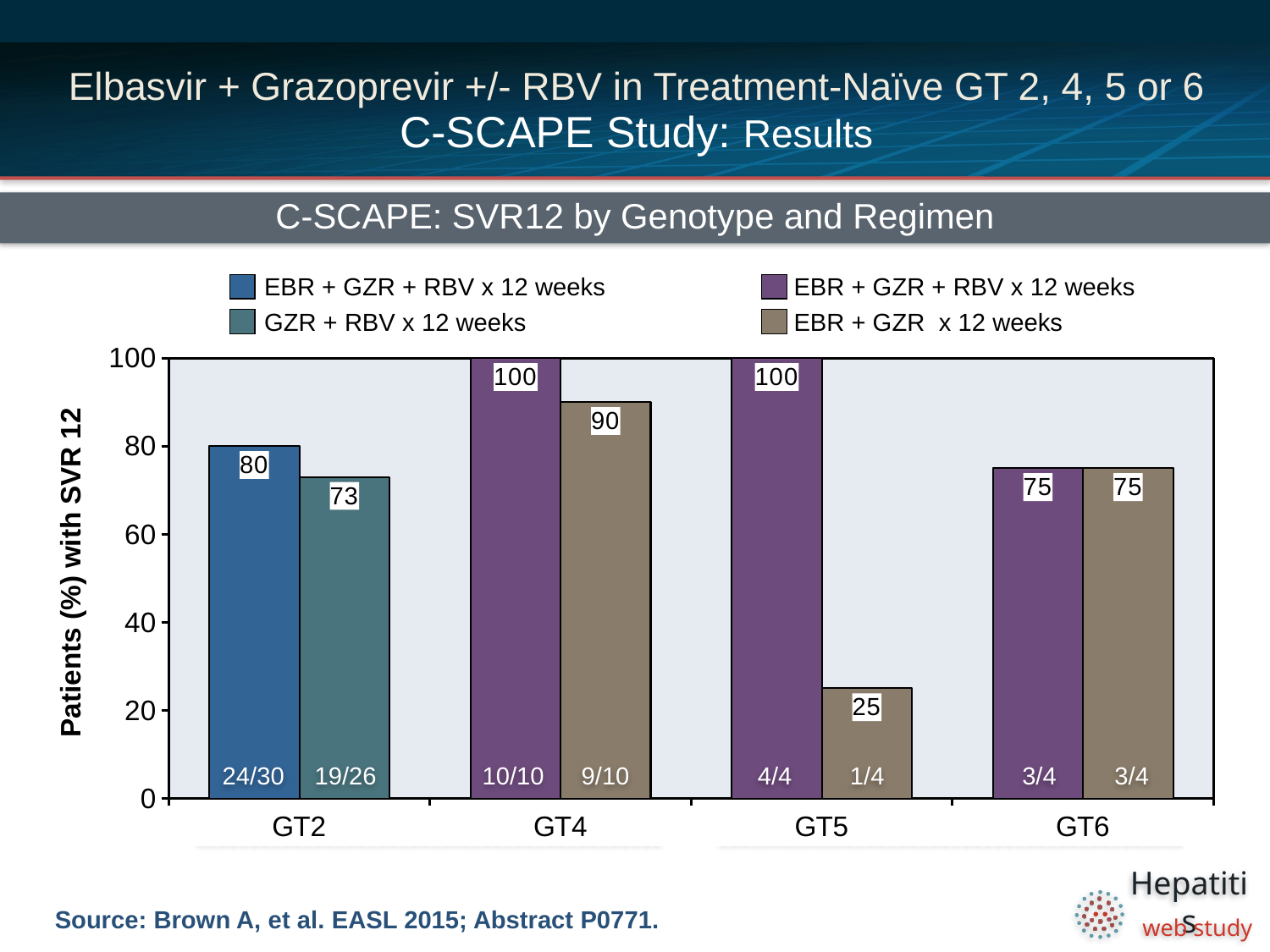
What is the difference between the two SVR12 values shown for GT5? 75 What type of chart is shown on the slide? Bar chart What is the SVR12 value for the EBR + GZR + RBV x 12 weeks (blue) bar in GT2? 80 Which bar has the lowest SVR12 value on the chart? EBR + GZR x 12 weeks in GT5 (25) What fraction of patients is shown at the base of the GZR + RBV x 12 weeks bar in GT2? 19/26 In GT4, which regimen has the higher SVR12 value: EBR + GZR + RBV x 12 weeks or EBR + GZR x 12 weeks? EBR + GZR + RBV x 12 weeks What is the SVR12 value for the EBR + GZR x 12 weeks bar in GT4? 90 How many genotype categories are shown on the x axis? 4 What is the difference between the two SVR12 values shown for GT2? 7 What is the SVR12 value for the EBR + GZR x 12 weeks bar in GT5? 25 Are the SVR12 values for GT6 greater or less than 60? greater How many entries does the legend list? 4